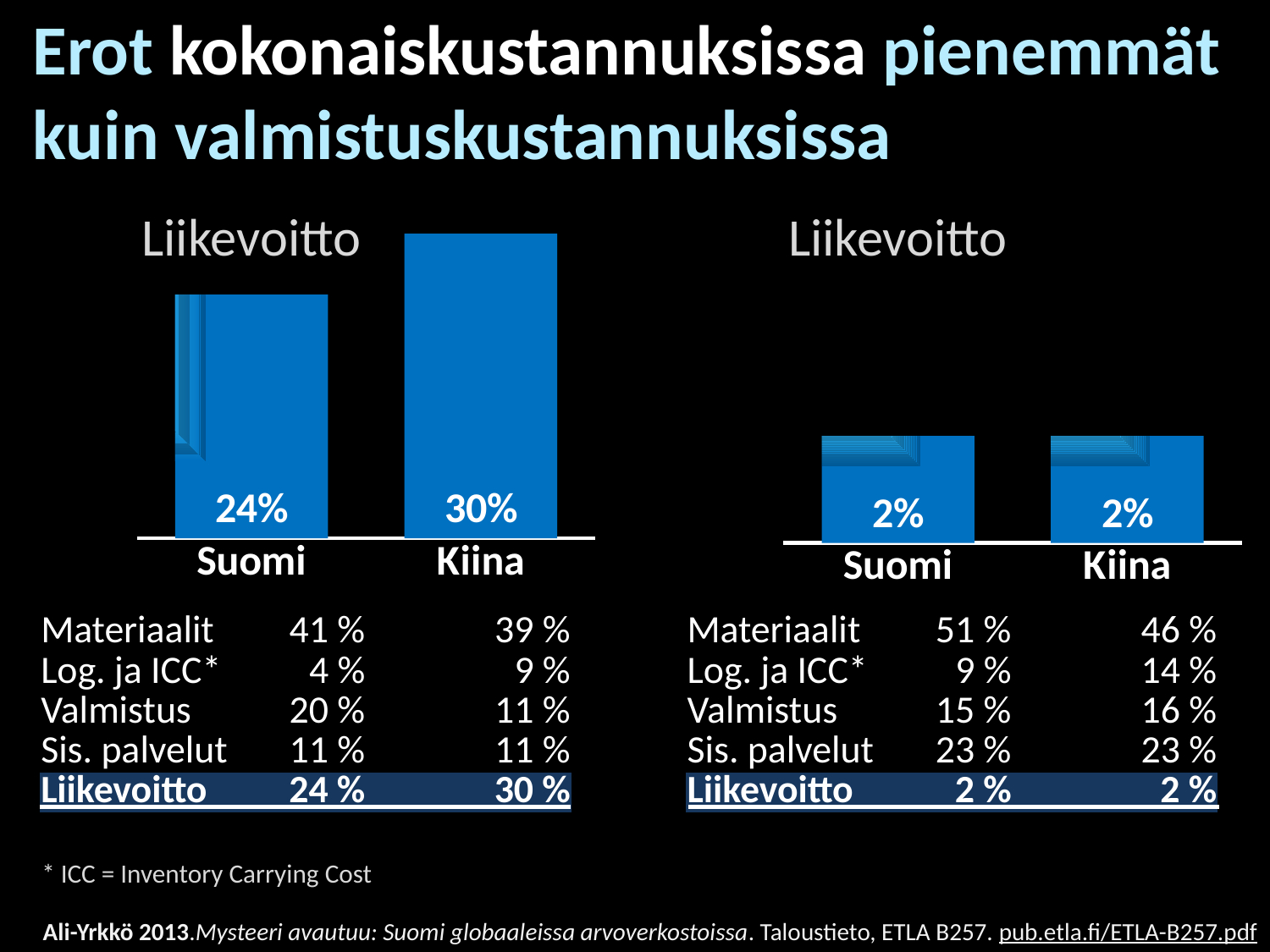
In the right chart, what is the value for Suomi? 2% How many categories does the right chart show? 2 In the right chart, what is the value for Kiina? 2% What type of chart is the right chart? bar chart In the left chart, which category has the highest value? Kiina In the left chart, which is larger, the value for Suomi or the value for Kiina? Kiina In the left chart, what is the value for Kiina? 30% How many categories does the left chart show? 2 In the left chart, which category has the lowest value? Suomi What is the title of the left chart? Liikevoitto In the left chart, what is the value for Suomi? 24% In the left chart, what is the difference between the values for Kiina and Suomi? 6%